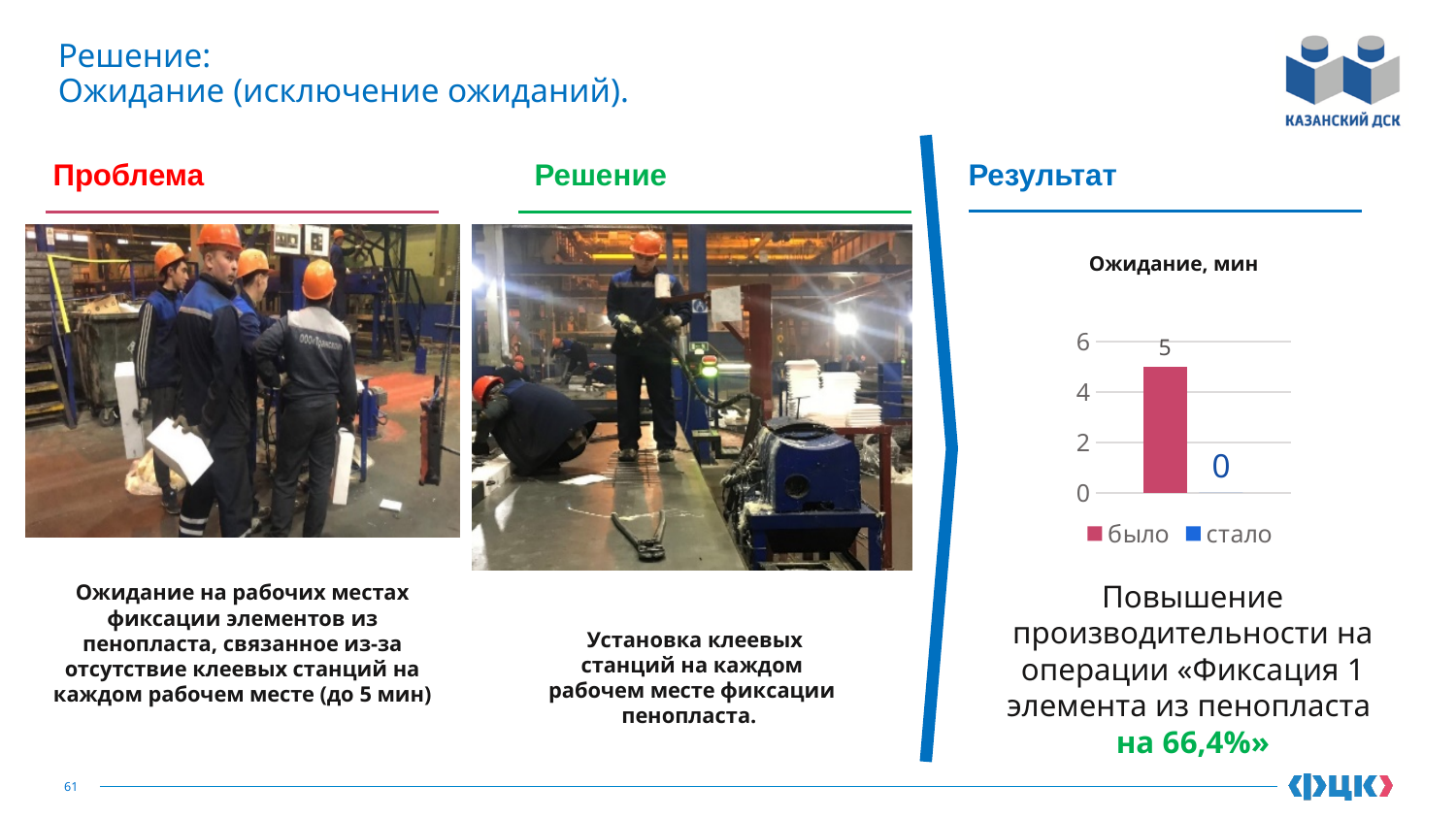
How many series does the chart legend list? 2 What is the highest tick value shown on the vertical axis of the chart? 6 What is the difference between the values for "было" and "стало"? 5 What are the two legend entries of the chart? было, стало What is the value for the series "было" in the chart? 5 Which series has the higher value, "было" or "стало"? было Which series has the lowest value in the chart? стало Is the value for "было" greater or less than 4? greater What is the value for the series "стало" in the chart? 0 What is the title of the chart on the slide? Ожидание, мин What type of chart is shown on the slide? bar chart